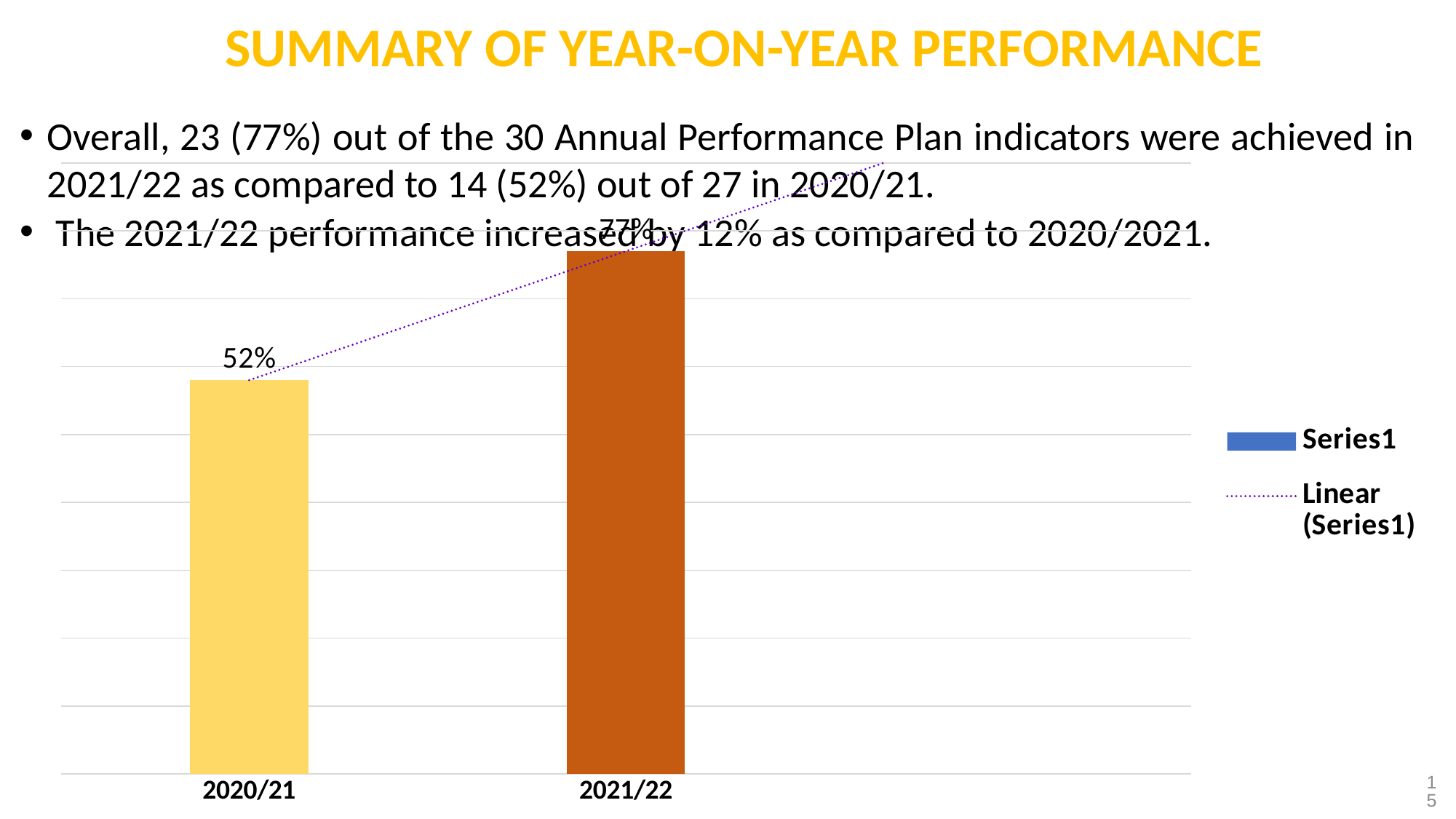
Which year has the higher value? 2021/22 How many categories are shown on the x axis? 2 What kind of chart is shown on the slide? bar chart How many entries does the legend list? 2 What is the value for 2021/22? 77% What is the second entry listed in the legend? Linear (Series1) What is the difference between the 2021/22 value and the 2020/21 value? 25% What is the value for 2020/21? 52% What colour is the bar for 2021/22? dark orange Do the values rise or fall from 2020/21 to 2021/22? rise Is the value for 2021/22 larger or smaller than the value for 2020/21? larger Which year has the lower value? 2020/21